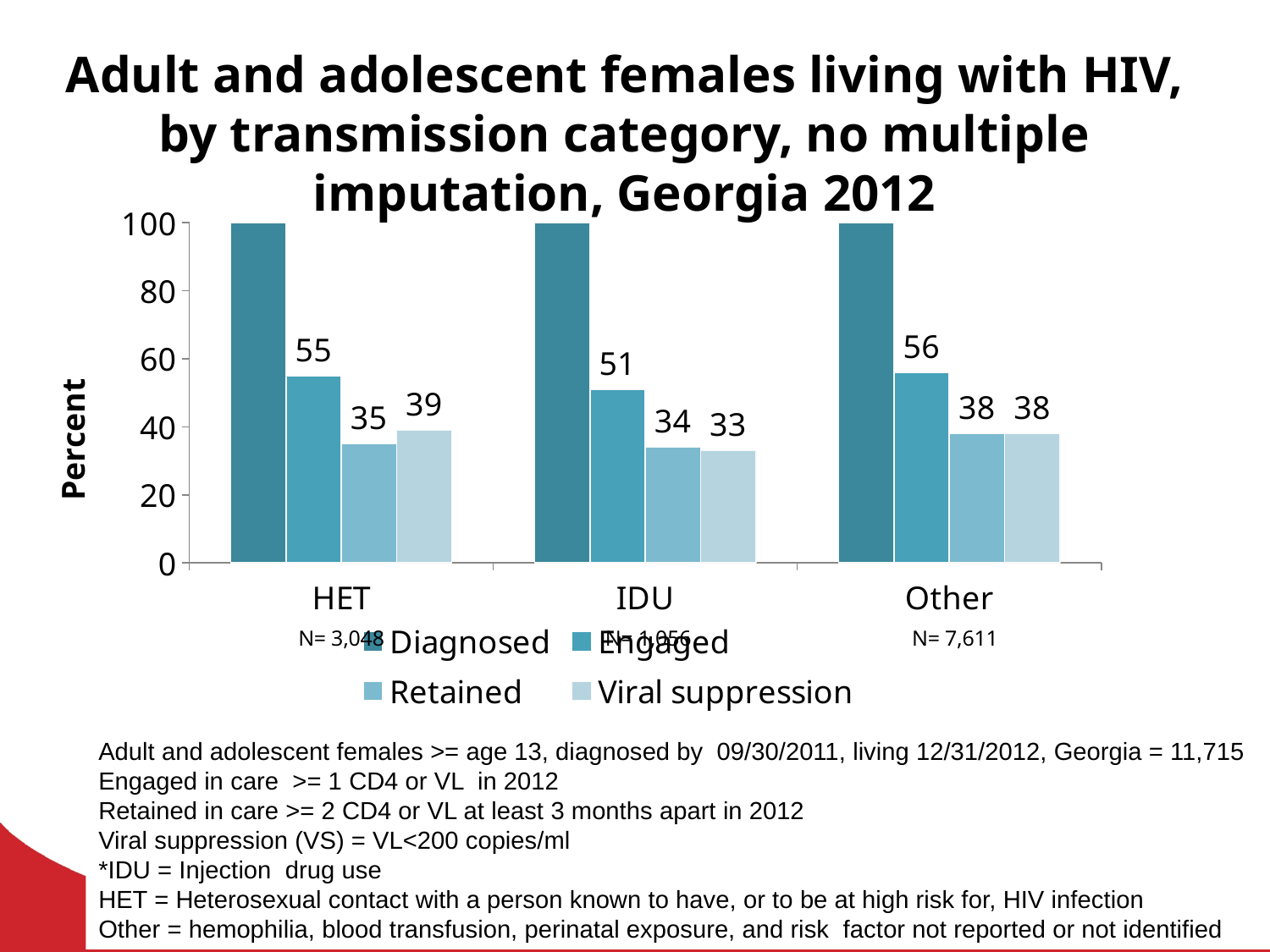
What kind of chart is shown on the slide? bar chart Which is larger for IDU, the Retained value or the Viral suppression value? Retained Which transmission category has the highest Engaged value? Other What is the Retained value for IDU? 34 What is the Engaged value for HET? 55 What is the Viral suppression value for HET? 39 Is the Diagnosed value for IDU greater or less than 80? greater How many series does the legend list? 4 Which transmission category has the lowest Viral suppression value? IDU What is the difference between the Engaged and Retained values for HET? 20 What is the Viral suppression value for Other? 38 How many transmission categories are shown on the x axis? 3